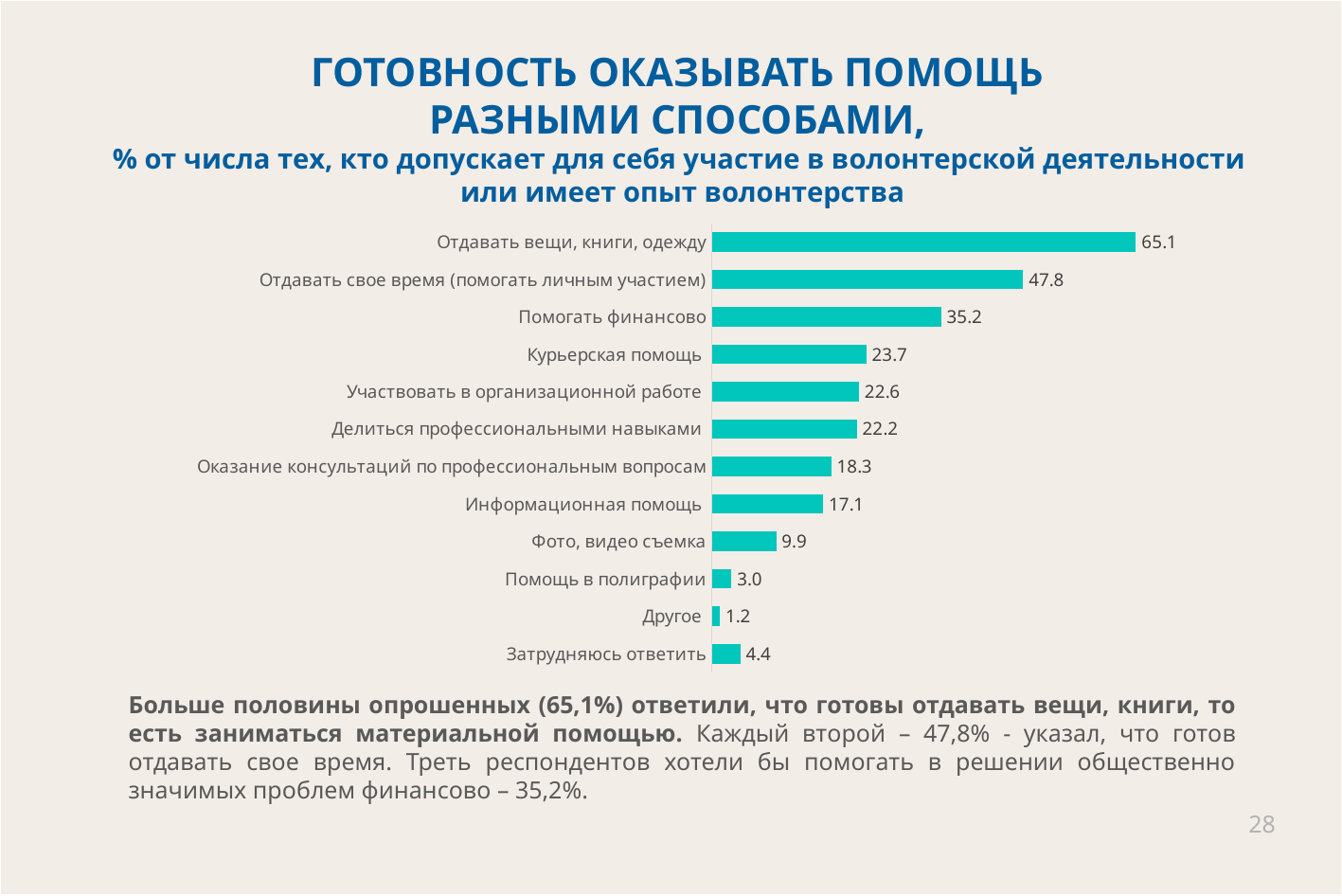
What is the value for «Отдавать вещи, книги, одежду»? 65.1 What kind of chart is shown on the slide? Bar chart How many categories are shown in the chart? 12 Which category has the highest value? Отдавать вещи, книги, одежду What is the value for «Затрудняюсь ответить»? 4.4 What is the difference between the values for «Курьерская помощь» and «Фото, видео съемка»? 13.8 What is the value for «Информационная помощь»? 17.1 What colour are the bars in the chart? Teal What is the difference between the values for «Отдавать вещи, книги, одежду» and «Отдавать свое время (помогать личным участием)»? 17.3 Which is larger: the value for «Оказание консультаций по профессиональным вопросам» or the value for «Информационная помощь»? Оказание консультаций по профессиональным вопросам What is the value for «Помогать финансово»? 35.2 Which category has the lowest value? Другое